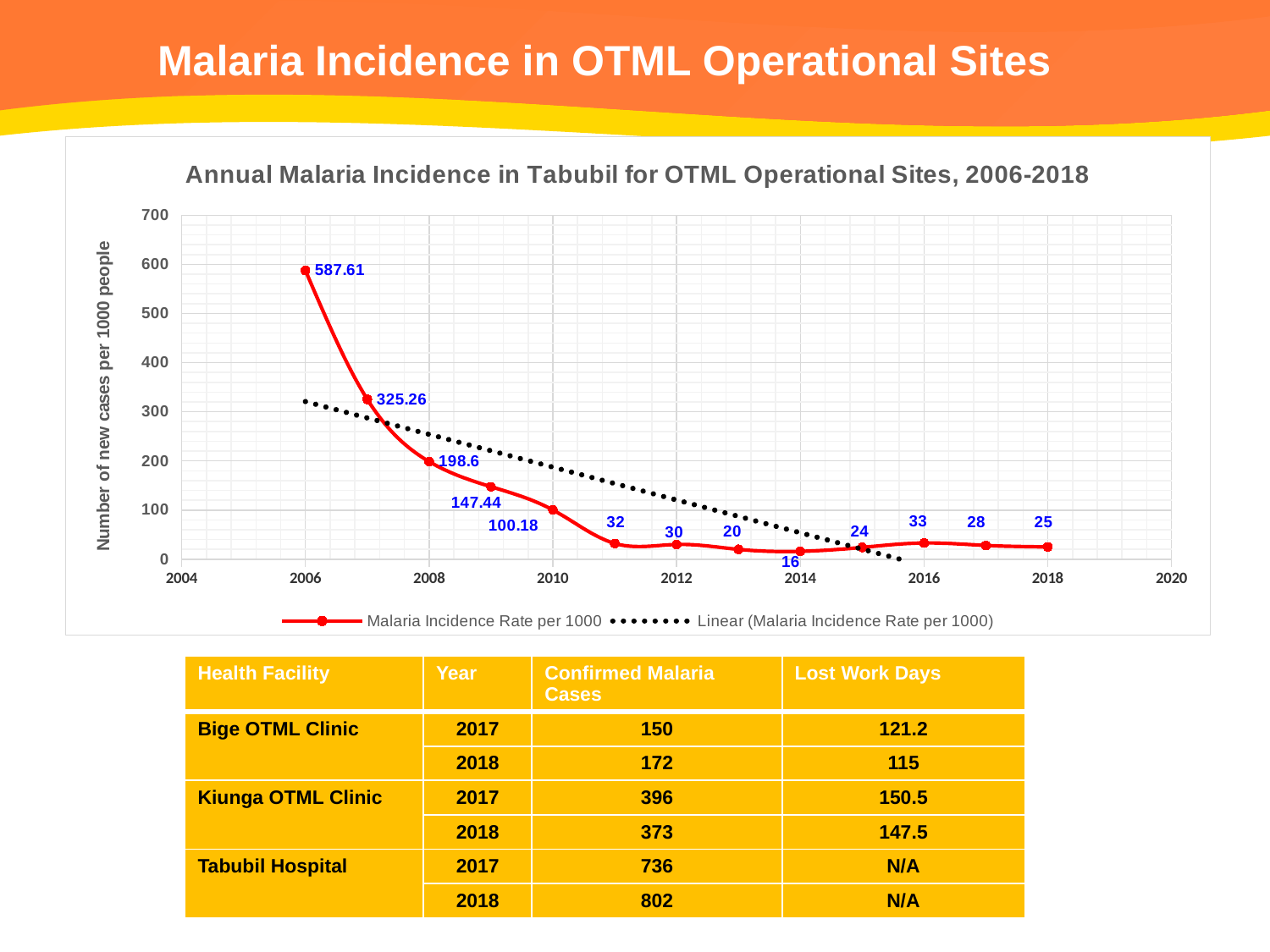
What is the malaria incidence rate per 1000 in 2010? 100.18 What is the malaria incidence rate per 1000 in 2006? 587.61 What is the difference between the malaria incidence rate in 2006 and in 2007? 262.35 Which year has the highest malaria incidence rate per 1000? 2006 Does the malaria incidence rate generally rise or fall from 2006 to 2018? Fall Which year has a higher malaria incidence rate per 1000, 2016 or 2017? 2016 What kind of chart is shown on the slide? Line chart What is the malaria incidence rate per 1000 in 2018? 25 Is the malaria incidence rate per 1000 in 2008 greater or less than 100? greater How many years are plotted on the malaria incidence line? 13 Which year has the lowest malaria incidence rate per 1000? 2014 How many entries does the chart legend list? 2